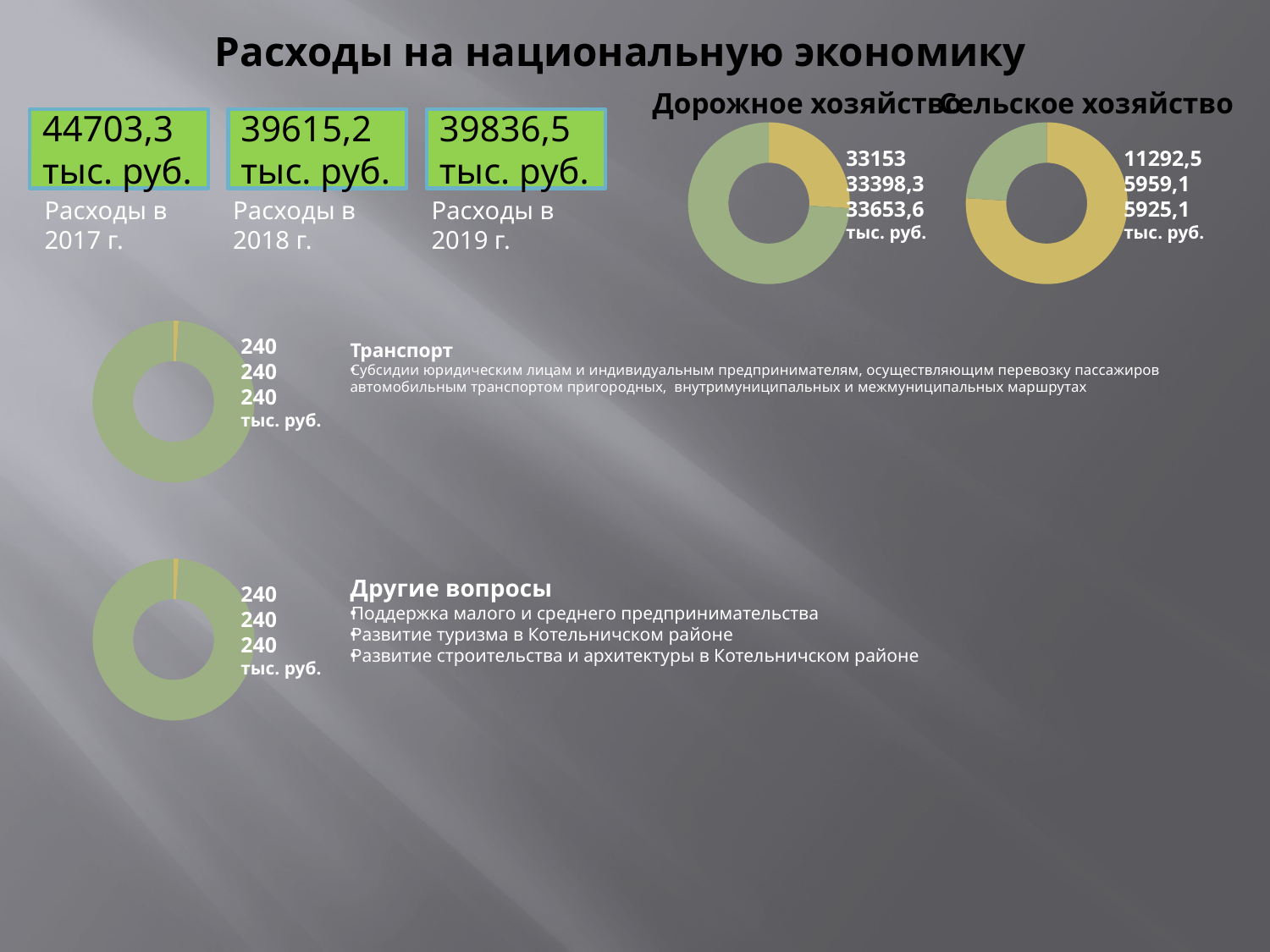
In the "Дорожное хозяйство" chart, what is the largest value listed? 33653,6 тыс. руб. In the "Сельское хозяйство" chart, what is the largest value listed? 11292,5 тыс. руб. How many values are listed next to the "Сельское хозяйство" chart? 3 In the "Дорожное хозяйство" chart, what is the difference between the largest value (33653,6) and the smallest value (33153)? 500,6 тыс. руб. In the "Дорожное хозяйство" chart, what is the smallest value listed? 33153 тыс. руб. How many charts are shown on the slide? 4 What is the total of the three values listed for the "Сельское хозяйство" chart? 23176,7 тыс. руб. What kind of chart is used for "Дорожное хозяйство"? Donut (pie) chart What value is listed for each of the three segments of the "Другие вопросы" chart? 240 тыс. руб. In the "Сельское хозяйство" chart, what is the difference between 11292,5 and 5959,1? 5333,4 тыс. руб. What is the total of the three values listed for the "Транспорт" chart? 720 тыс. руб. In the "Сельское хозяйство" chart, what is the smallest value listed? 5925,1 тыс. руб.